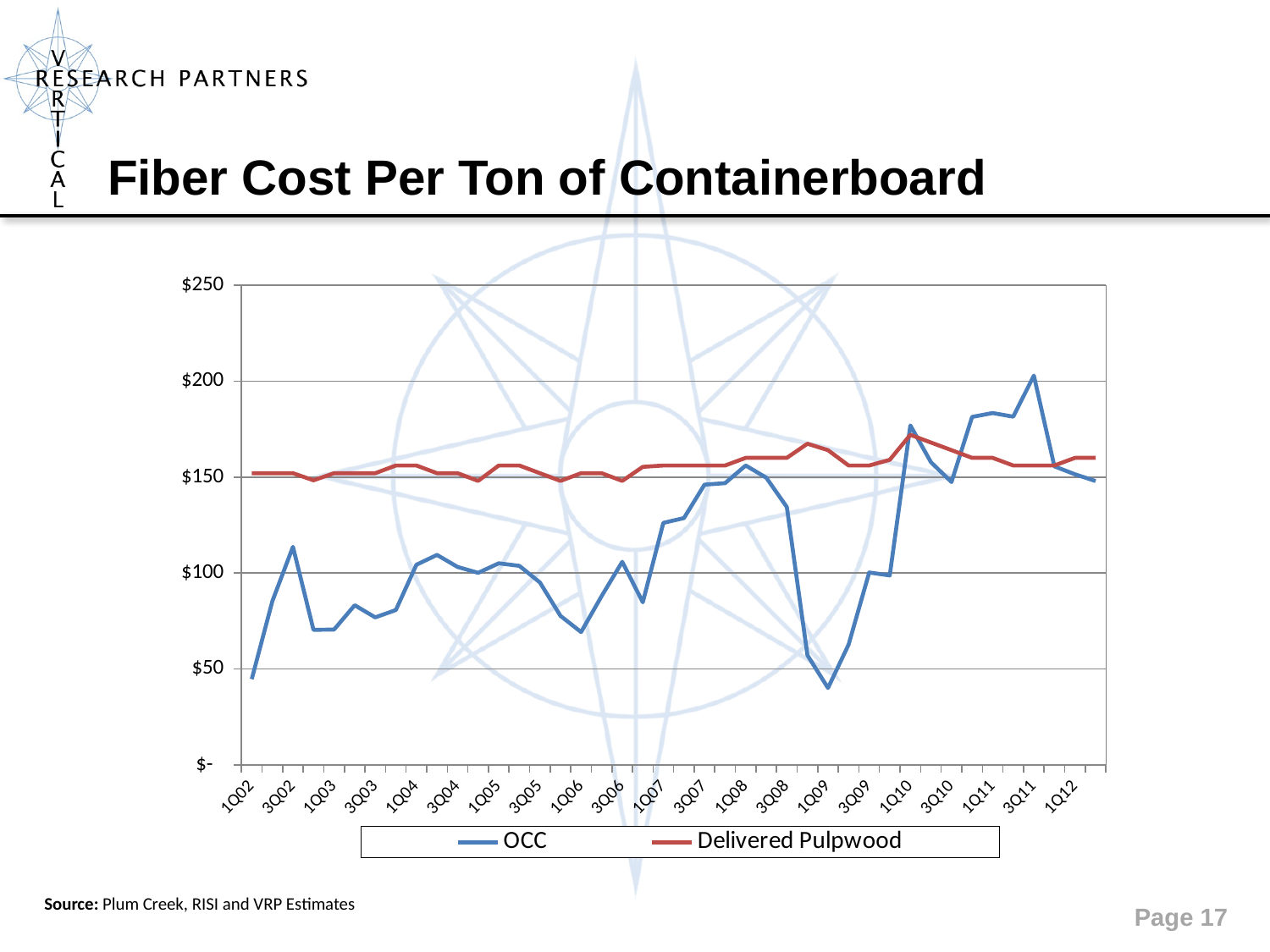
Which series is drawn in red? Delivered Pulpwood What kind of chart is shown on the slide? line chart What is the title of the chart? Fiber Cost Per Ton of Containerboard Is the OCC value at 3Q02 greater or less than $100? greater Does the OCC line rise or fall between 1Q09 and 1Q10? rise At 1Q09, which series has the higher value, OCC or Delivered Pulpwood? Delivered Pulpwood Is the OCC value at 1Q11 greater or less than $150? greater Is the Delivered Pulpwood value at 1Q09 greater or less than $150? greater How many series does the legend list? 2 At 3Q11, which series has the higher value, OCC or Delivered Pulpwood? OCC